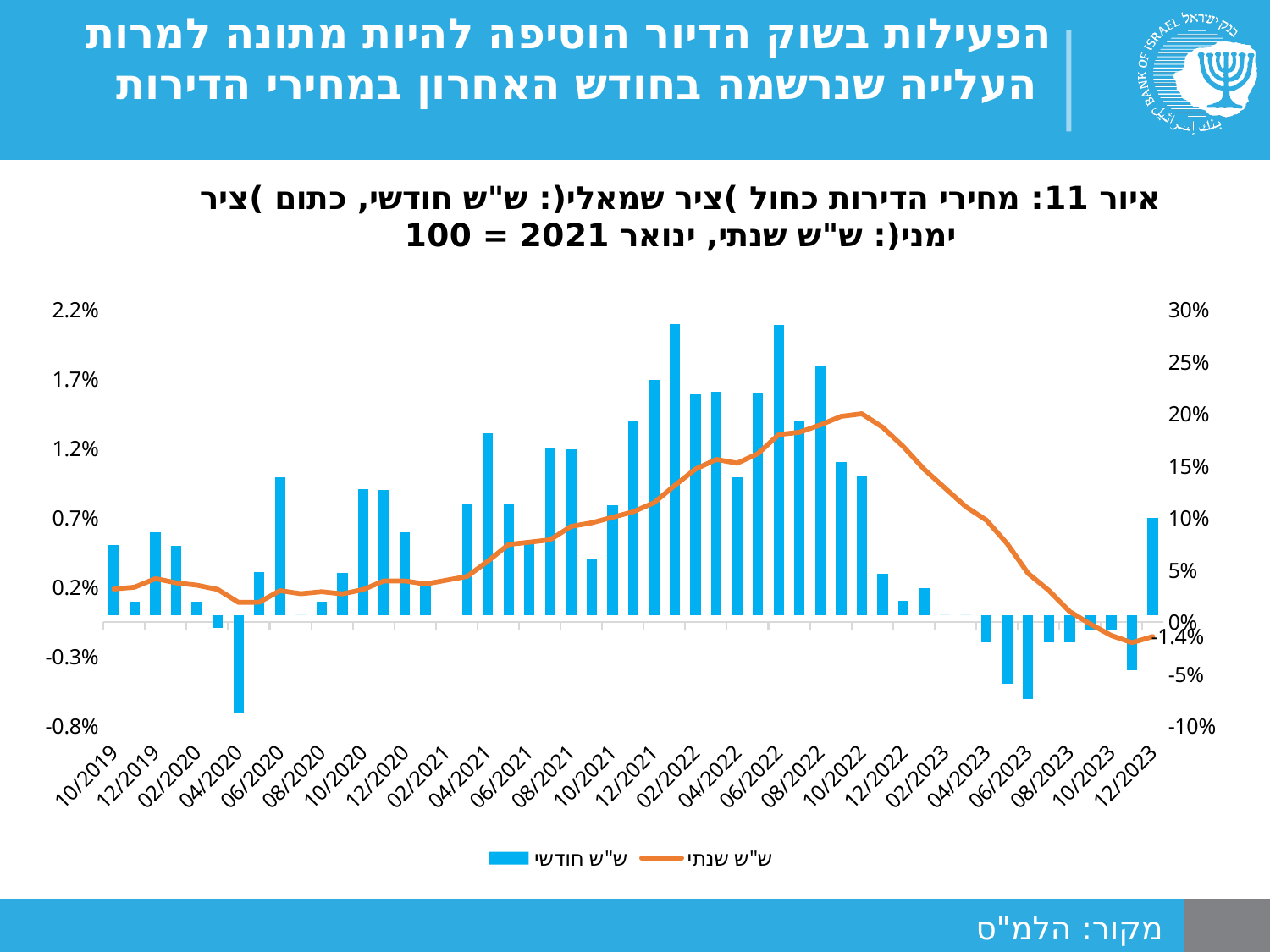
Is the annual (ש"ש שנתי) line at 10/2019 greater or less than 10% on the right axis? less Which monthly (ש"ש חודשי) bar is taller, 02/2022 or 12/2022? 02/2022 Is the monthly (ש"ש חודשי) bar for 04/2020 greater or less than -0.3% on the left axis? less What is the value printed at the end of the annual (ש"ש שנתי) line for 12/2023? -1.4% Is the monthly (ש"ש חודשי) bar for 12/2023 greater or less than 0.2% on the left axis? greater Does the annual (ש"ש שנתי) line rise or fall between 04/2020 and 10/2022? rise What source is cited at the bottom of the slide? הלמ"ס How many series does the legend list? 2 Does the annual (ש"ש שנתי) line rise or fall between 10/2022 and 10/2023? fall What kind of chart is shown on the slide? A combination bar and line chart What are the two series named in the legend? ש"ש חודשי and ש"ש שנתי